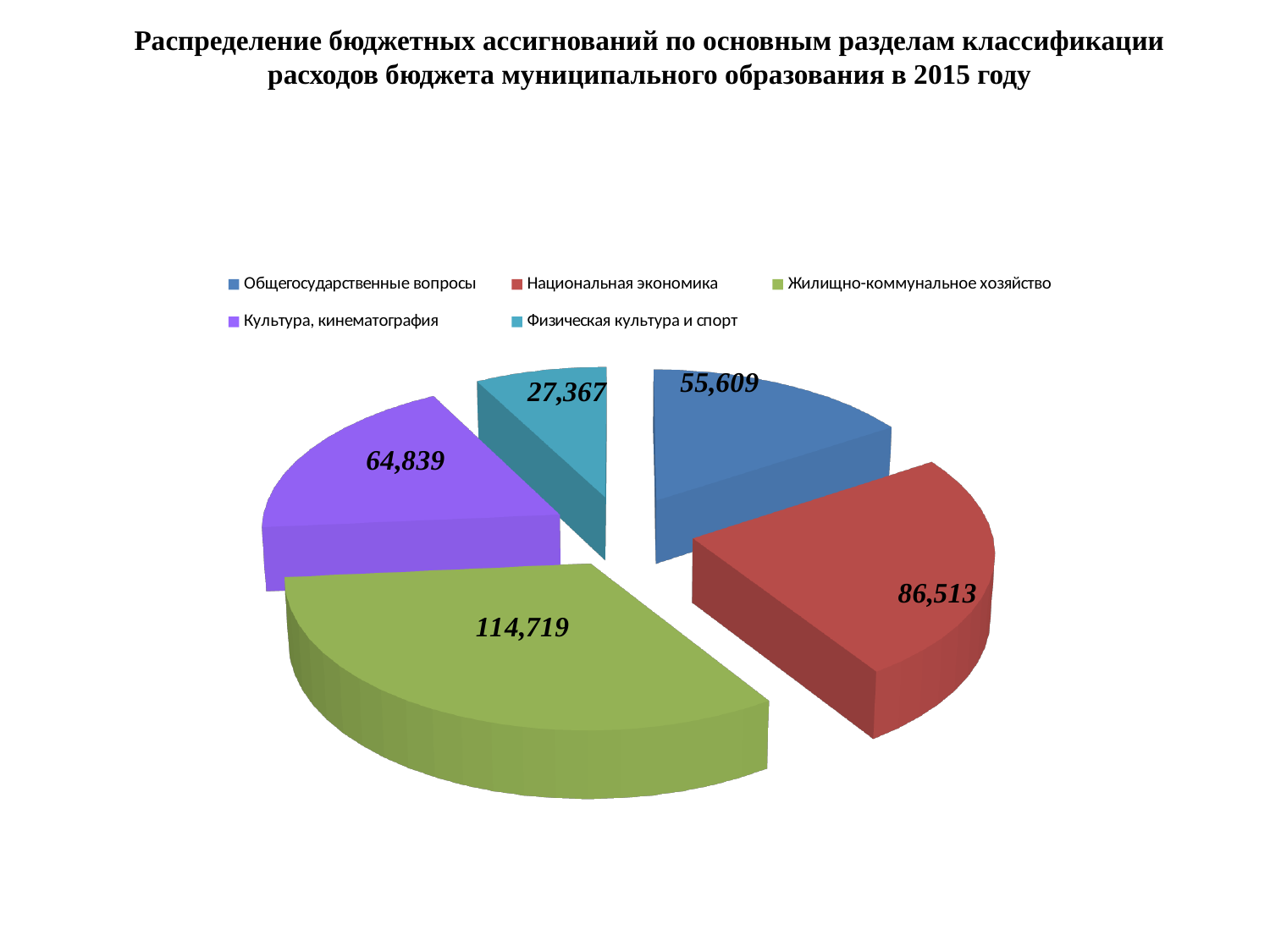
What type of chart is shown on the slide? Pie chart Which category has the smallest slice of the pie? Физическая культура и спорт What is the value for Жилищно-коммунальное хозяйство? 114,719 How many categories does the pie chart show? 5 What is the value for Культура, кинематография? 64,839 What is the difference between the values for Жилищно-коммунальное хозяйство and Национальная экономика? 28,206 What is the value for Национальная экономика? 86,513 Which category has the largest slice of the pie? Жилищно-коммунальное хозяйство Which is larger: the value for Культура, кинематография or the value for Общегосударственные вопросы? Культура, кинематография Which colour represents Национальная экономика in the legend? Red What is the total of all the slices in the pie chart? 349,047 What is the value for Физическая культура и спорт? 27,367